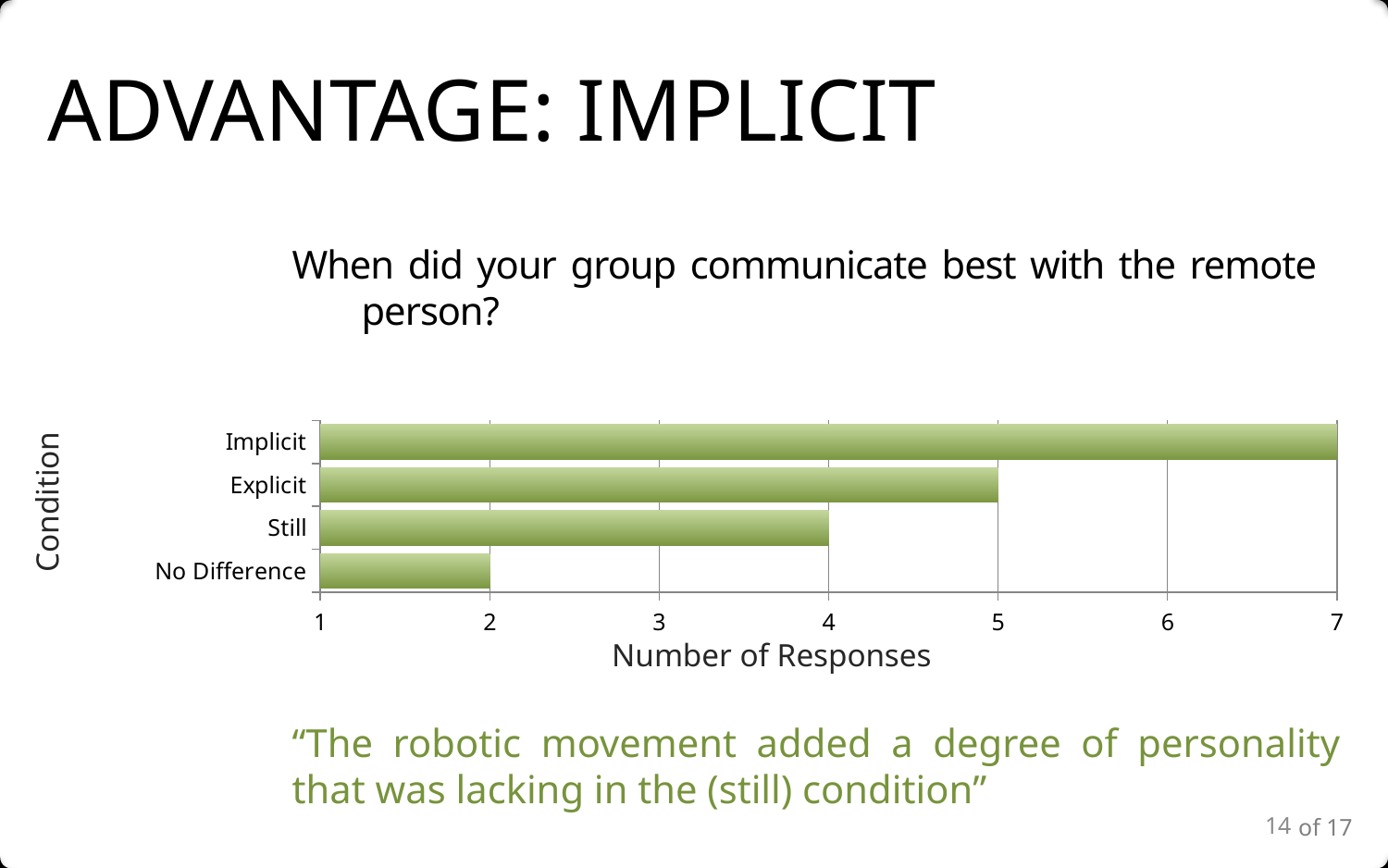
What is the number of responses for the Explicit condition? 5 What is the label of the horizontal axis? Number of Responses What is the label of the vertical axis? Condition What is the number of responses for No Difference? 2 Which condition received the most responses? Implicit What is the number of responses for the Implicit condition? 7 What kind of chart is shown on the slide? bar chart Which received more responses, Still or No Difference? Still Which condition received the fewest responses? No Difference How many conditions are plotted on the chart? 4 How many more responses did Implicit receive than Explicit? 2 What is the number of responses for the Still condition? 4